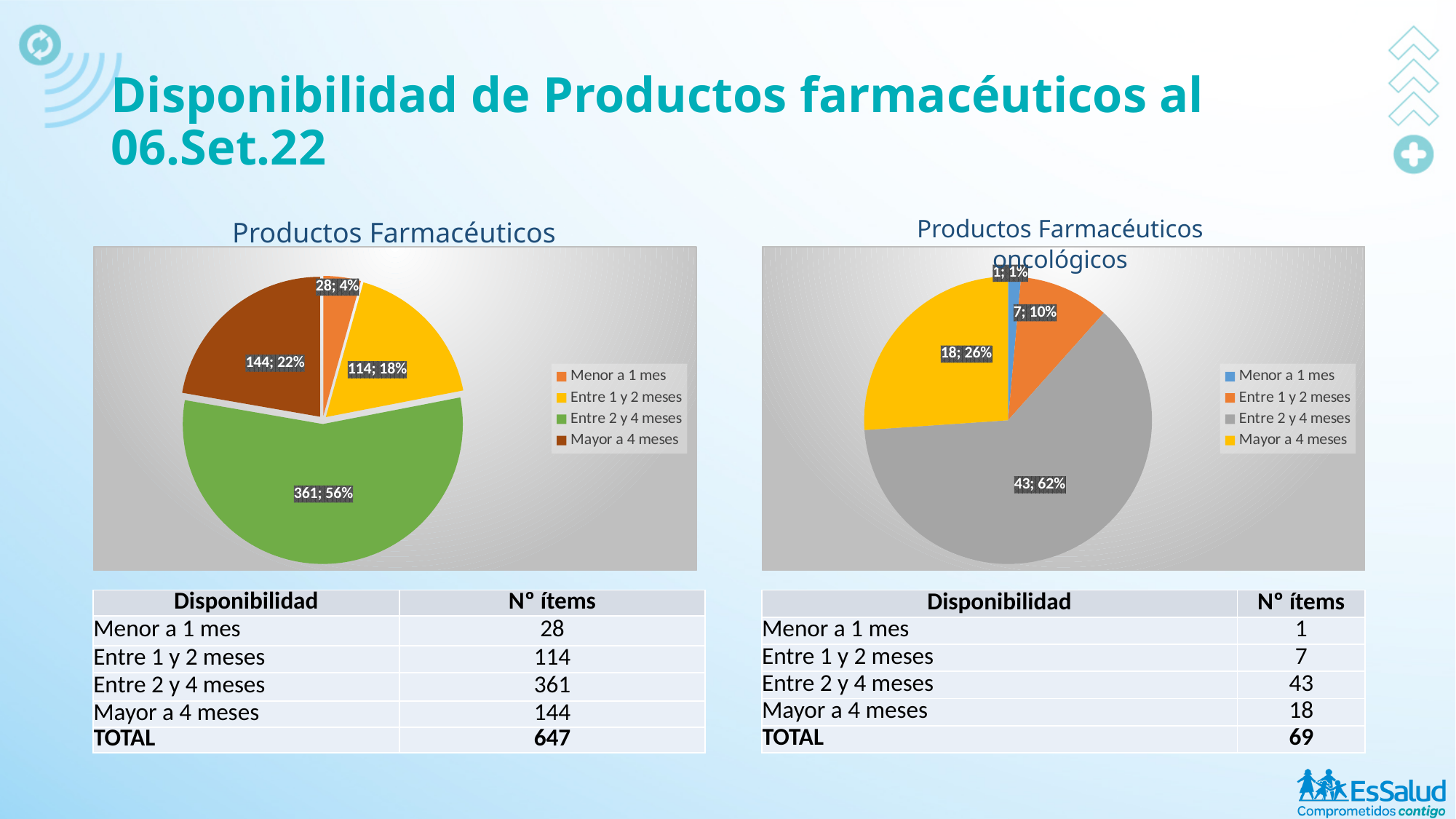
In the 'Productos Farmacéuticos' pie chart, what share of the pie does 'Mayor a 4 meses' represent? 22% In the 'Productos Farmacéuticos oncológicos' pie chart, what is the value for 'Entre 1 y 2 meses'? 7 In the 'Productos Farmacéuticos oncológicos' pie chart, what is the total of all slices? 69 What kind of chart is 'Productos Farmacéuticos oncológicos'? Pie chart In the 'Productos Farmacéuticos' pie chart, what is the value for 'Entre 2 y 4 meses'? 361 In the 'Productos Farmacéuticos oncológicos' pie chart, which is larger: 'Mayor a 4 meses' or 'Entre 1 y 2 meses'? Mayor a 4 meses In the 'Productos Farmacéuticos' pie chart, which category has the smallest slice? Menor a 1 mes In the 'Productos Farmacéuticos oncológicos' pie chart, what share of the pie does 'Mayor a 4 meses' represent? 26% In the 'Productos Farmacéuticos' pie chart, what is the difference between the values for 'Mayor a 4 meses' and 'Entre 1 y 2 meses'? 30 In the 'Productos Farmacéuticos oncológicos' pie chart, which category has the largest slice? Entre 2 y 4 meses In the 'Productos Farmacéuticos' pie chart, how many categories are shown? 4 In the 'Productos Farmacéuticos oncológicos' pie chart, what colour is the 'Entre 2 y 4 meses' slice? Grey